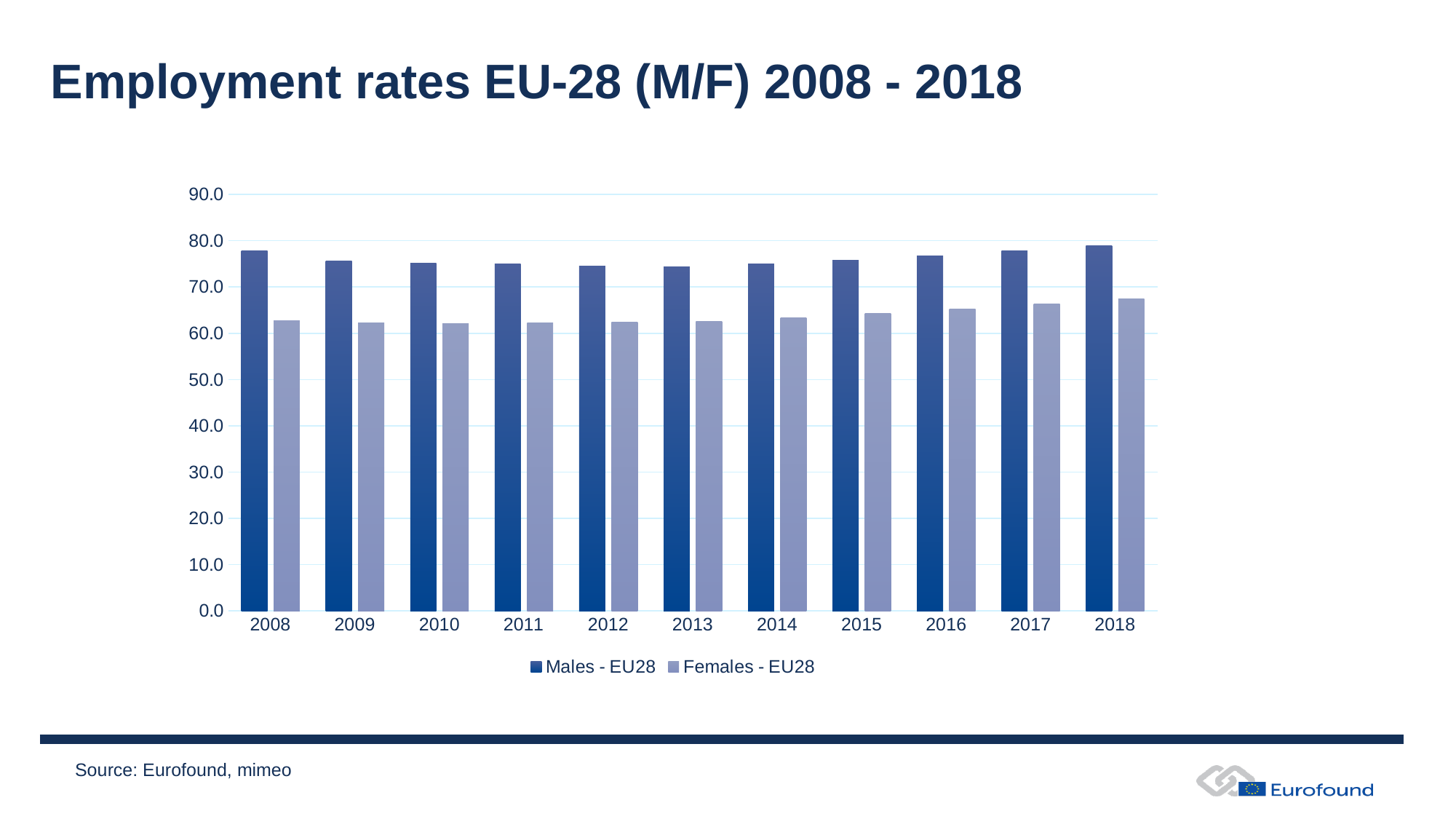
What is the title of the chart on the slide? Employment rates EU-28 (M/F) 2008 - 2018 Which year has the highest value for Females - EU28? 2018 Which is larger: Males - EU28 in 2018 or Males - EU28 in 2013? Males - EU28 in 2018 What kind of chart is shown on the slide? bar chart Is the value for Males - EU28 in 2013 greater or less than 80.0? less Do the values for Females - EU28 rise or fall from 2013 to 2018? rise How many years are shown on the x axis? 11 Which year has the highest value for Males - EU28? 2018 Is the value for Females - EU28 in 2008 greater or less than 60.0? greater Is the value for Males - EU28 in 2008 greater or less than 70.0? greater How many series does the legend list? 2